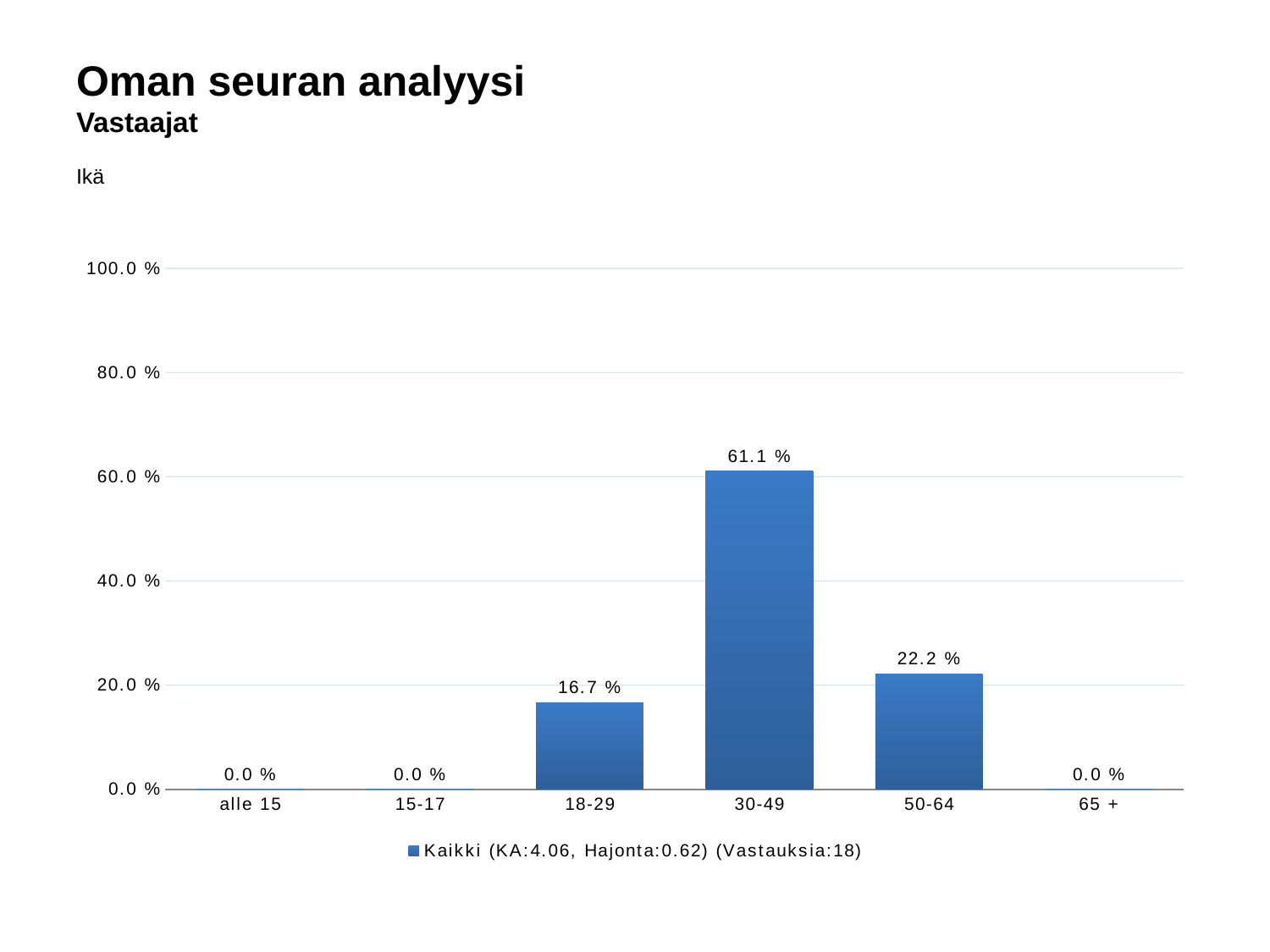
What is the value for the 65 + age group? 0.0 % What is the difference between the values for 30-49 and 50-64? 38.9 % Which age group has the highest value? 30-49 What is the value for the 50-64 age group? 22.2 % Is the value for 30-49 greater or less than 60.0 %? greater What is the difference between the values for 50-64 and 18-29? 5.5 % What kind of chart is shown on the slide? bar chart How many responses (Vastauksia) does the legend report? 18 What is the value for the 30-49 age group? 61.1 % Which is larger, the value for 18-29 or the value for 50-64? 50-64 How many age categories are shown on the x axis? 6 What is the value for the 18-29 age group? 16.7 %